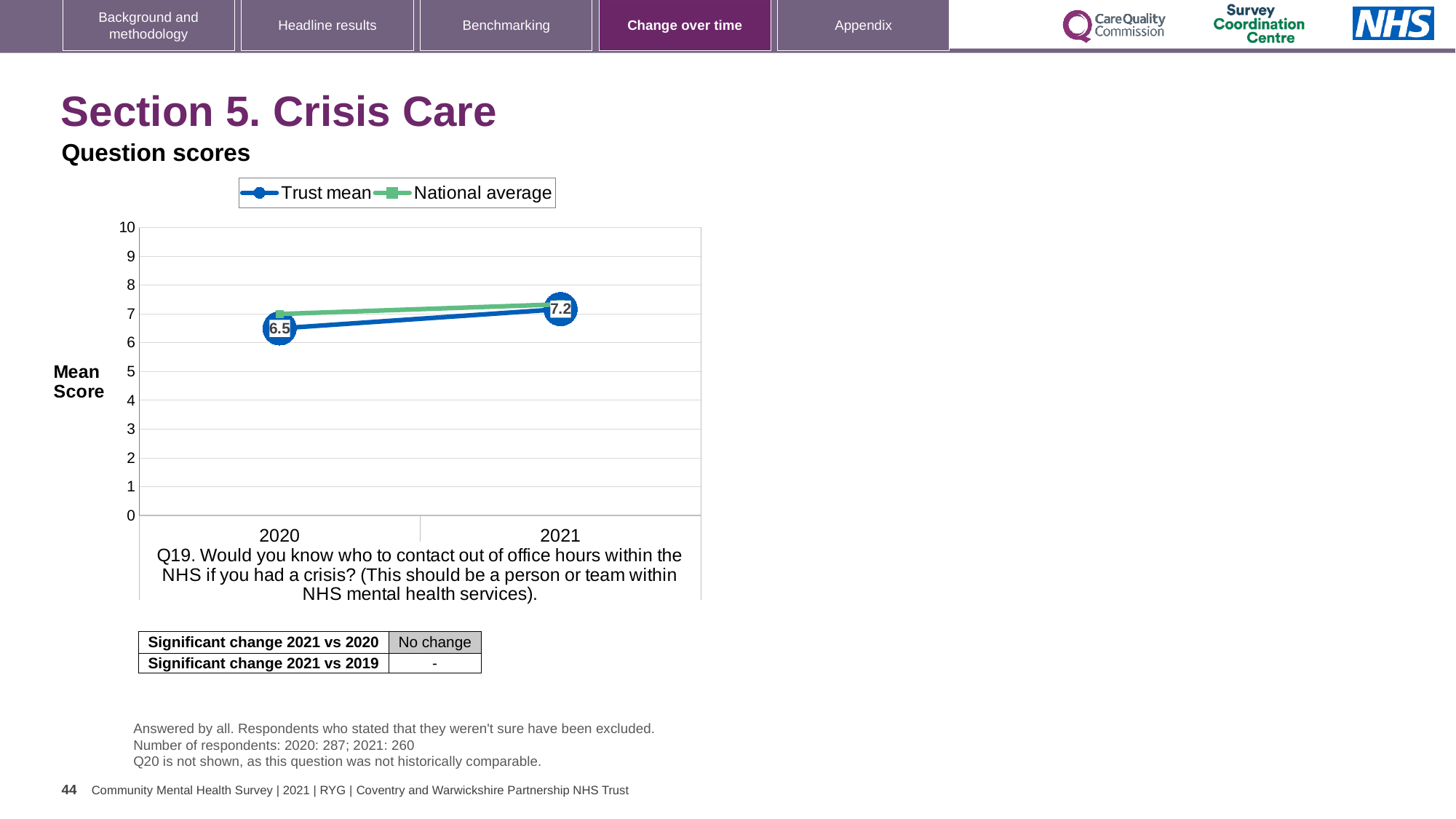
In 2020, which series has the higher value, Trust mean or National average? National average What is the label on the y axis of the chart? Mean Score What type of chart is shown on the slide? line chart By how much did the Trust mean score change from 2020 to 2021? 0.7 What is the Trust mean score for 2020? 6.5 How many series does the chart legend list? 2 What is the Trust mean score for 2021? 7.2 Is the Trust mean value for 2020 greater or less than 7? less How many years are plotted on the x axis of the chart? 2 Does the Trust mean rise or fall from 2020 to 2021? rise Is the National average value for 2020 greater or less than 5? greater Which year has the higher Trust mean score, 2020 or 2021? 2021